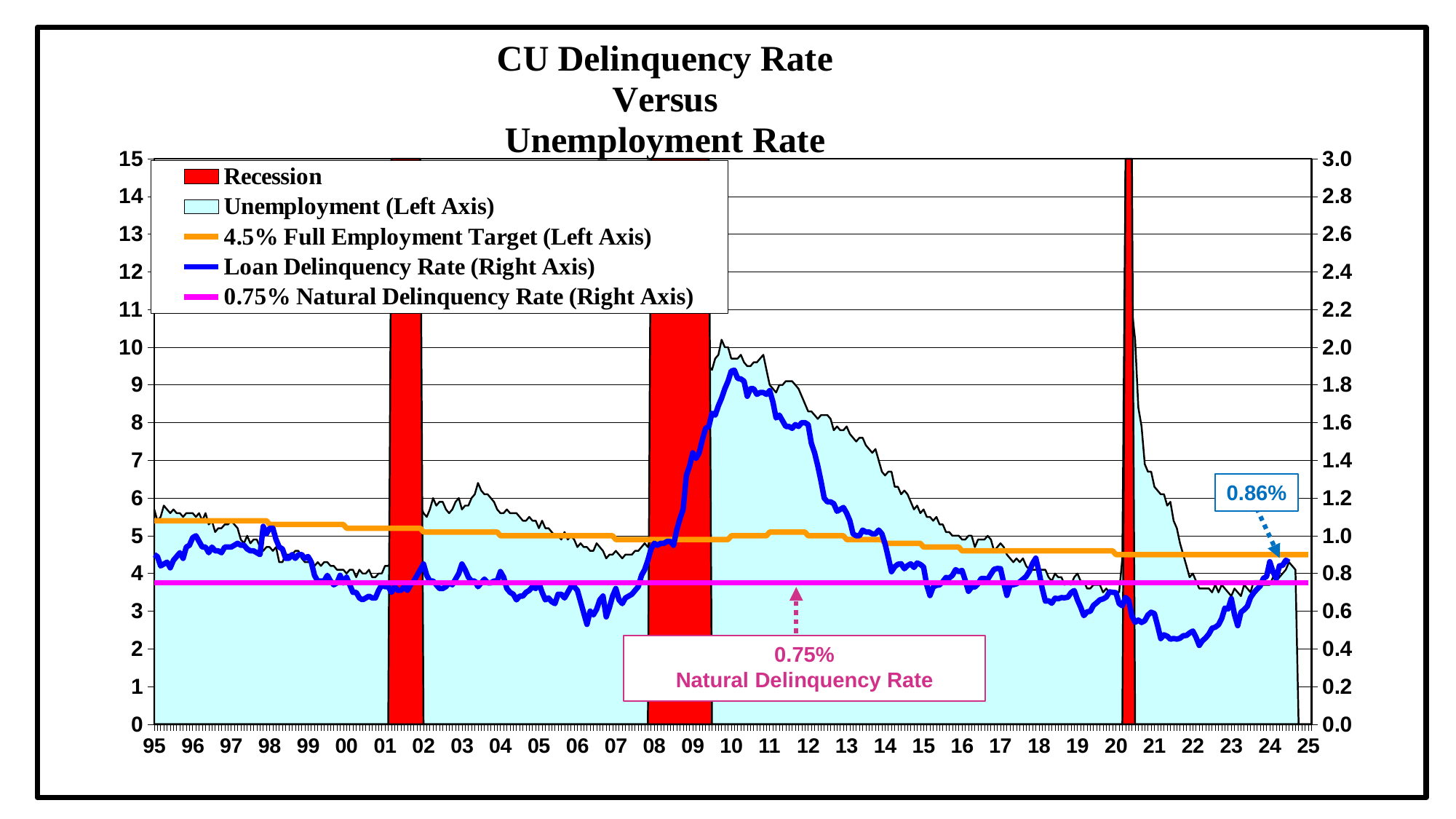
What kind of chart is shown on the slide? combination area and line chart How many entries does the chart's legend list? 5 Which is larger, the Loan Delinquency Rate around year 10 or around year 22? year 10 What is the title of the chart? CU Delinquency Rate Versus Unemployment Rate How many Recession bands are shaded on the chart? 3 Is the Loan Delinquency Rate around year 22 greater or less than 0.6 on the right axis? less Does the Unemployment series rise or fall between year 10 and year 19? fall Is the Unemployment value around year 10 greater or less than 8 on the left axis? greater What value is given for the Natural Delinquency Rate? 0.75% In which year on the x axis does the Unemployment series reach its highest point? 20 What is the most recent Loan Delinquency Rate value labeled on the chart? 0.86% Is the labeled 0.86% Loan Delinquency Rate greater or less than the 0.75% Natural Delinquency Rate? greater